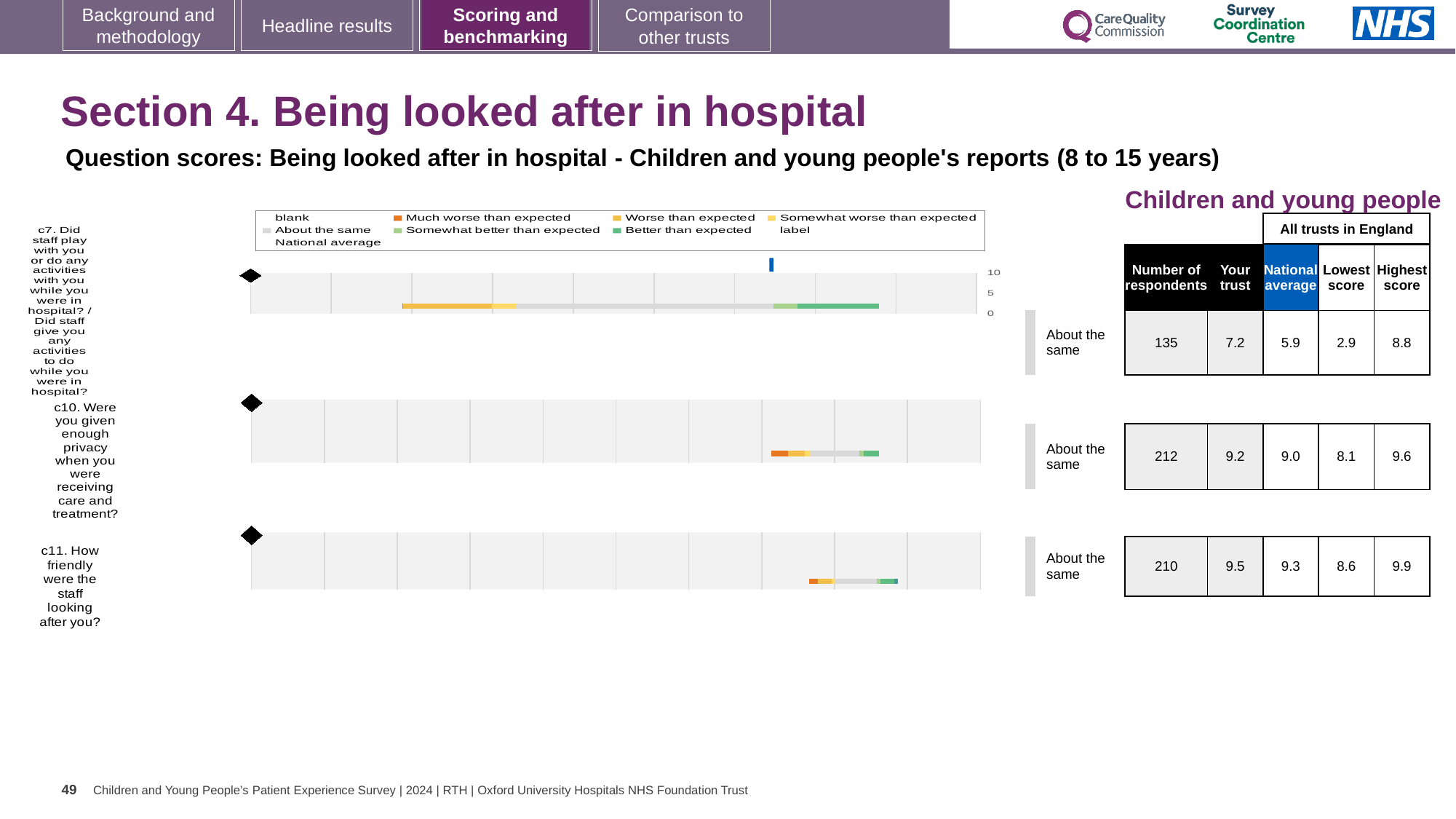
How many respondents answered question c10? 212 What benchmark category is shown for question c10? About the same For question c10, what is the difference between the highest score and the lowest score among all trusts in England? 1.5 Which of the three questions shown has the lowest 'Your trust' score? c7 For question c7, what is the difference between the 'Your trust' score and the national average? 1.3 For question c11, which is larger: the 'Your trust' score or the national average? Your trust What is the national average score for question c10 (Were you given enough privacy when you were receiving care and treatment?)? 9.0 Is the 'Your trust' score for question c7 greater or less than 5? greater Which of the three questions shown has the highest 'Your trust' score? c11 How many questions are plotted on this slide? 3 What is the highest score among all trusts in England for question c11 (How friendly were the staff looking after you?)? 9.9 What is the 'Your trust' score for question c7 (Did staff play with you or do any activities with you while you were in hospital?)? 7.2